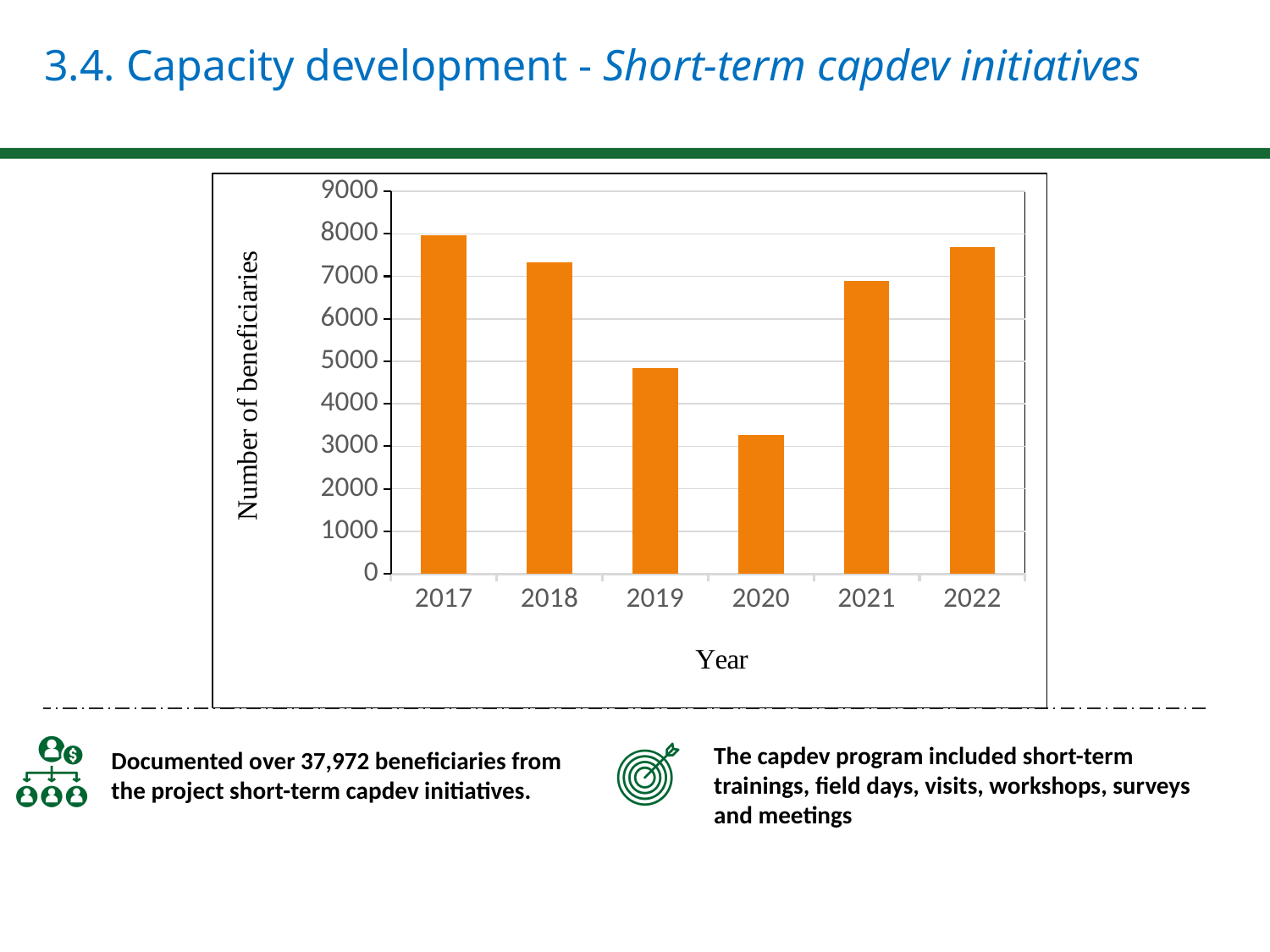
Which year has more beneficiaries, 2017 or 2019? 2017 Is the number of beneficiaries for 2022 greater or less than 7000? greater Is the number of beneficiaries for 2019 greater or less than 5000? less Is the number of beneficiaries for 2021 greater or less than 6000? greater What kind of chart is shown on the slide? Bar chart How many years are shown on the x axis of the chart? 6 Which year has the lowest number of beneficiaries? 2020 What is the label on the vertical axis of the chart? Number of beneficiaries Which year has more beneficiaries, 2019 or 2020? 2019 Do the number of beneficiaries rise or fall from 2017 to 2020? fall